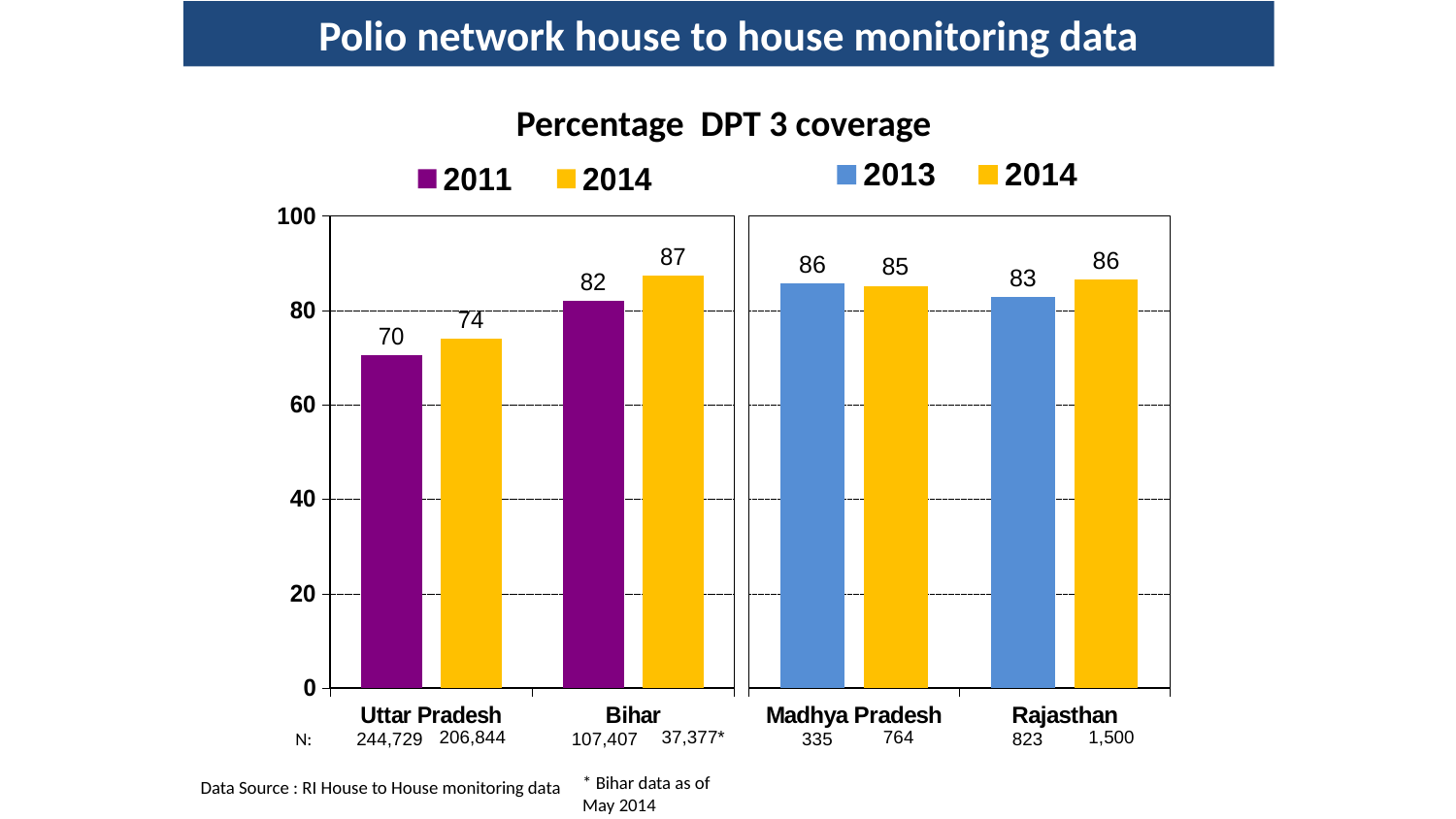
In the left chart (Uttar Pradesh and Bihar), which state has the lowest 2011 value? Uttar Pradesh What kind of chart is the left chart (Uttar Pradesh and Bihar)? bar chart In the left chart (Uttar Pradesh and Bihar), what is the difference between the 2014 and 2011 values for Uttar Pradesh? 4 How many series does the legend of the right chart (Madhya Pradesh and Rajasthan) list? 2 In the right chart (Madhya Pradesh and Rajasthan), which is larger for Madhya Pradesh: the 2013 value or the 2014 value? 2013 In the left chart (Uttar Pradesh and Bihar), what is the 2014 value for Bihar? 87 What are the two years listed in the legend of the left chart (Uttar Pradesh and Bihar)? 2011 and 2014 In the left chart (Uttar Pradesh and Bihar), is the 2011 value for Uttar Pradesh greater or less than 80? less In the right chart (Madhya Pradesh and Rajasthan), what is the 2014 value for Madhya Pradesh? 85 In the left chart (Uttar Pradesh and Bihar), what is the 2011 value for Uttar Pradesh? 70 In the right chart (Madhya Pradesh and Rajasthan), what is the 2013 value for Rajasthan? 83 In the left chart (Uttar Pradesh and Bihar), what is the difference between the 2014 and 2011 values for Bihar? 5